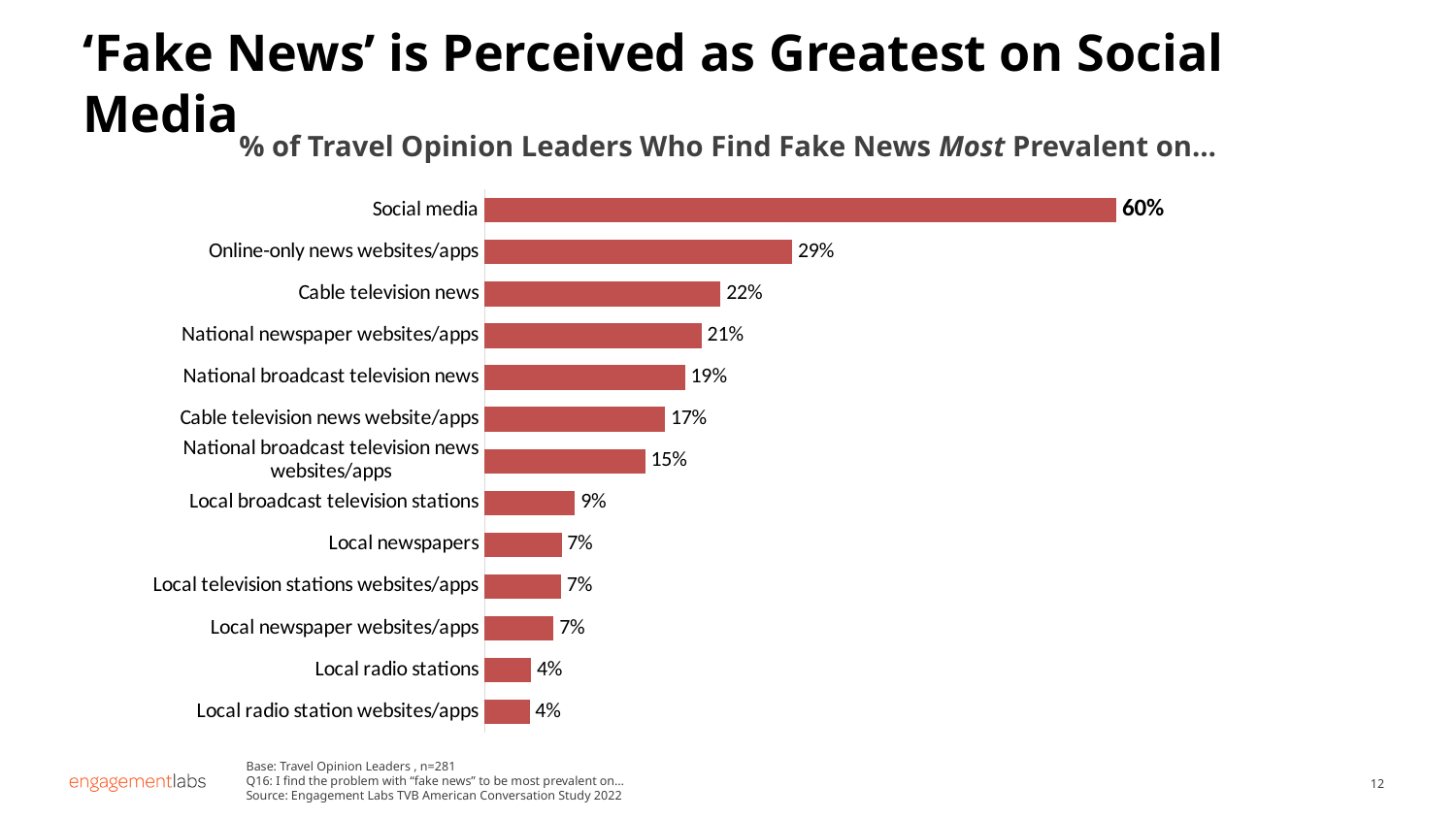
What is the title of the chart? % of Travel Opinion Leaders Who Find Fake News Most Prevalent on… What type of chart is shown on the slide? Bar chart What is the difference between the values for Social media and Online-only news websites/apps? 31% What is the difference between the values for Cable television news and National newspaper websites/apps? 1% How many categories are shown in the chart? 13 What is the value for National broadcast television news websites/apps? 15% What is the value for Online-only news websites/apps? 29% What percentage of Travel Opinion Leaders find fake news most prevalent on social media? 60% Which has a larger value, National broadcast television news or Cable television news website/apps? National broadcast television news What is the value for Cable television news? 22% Which two categories share the lowest value in the chart? Local radio stations and Local radio station websites/apps Which category has the highest value in the chart? Social media